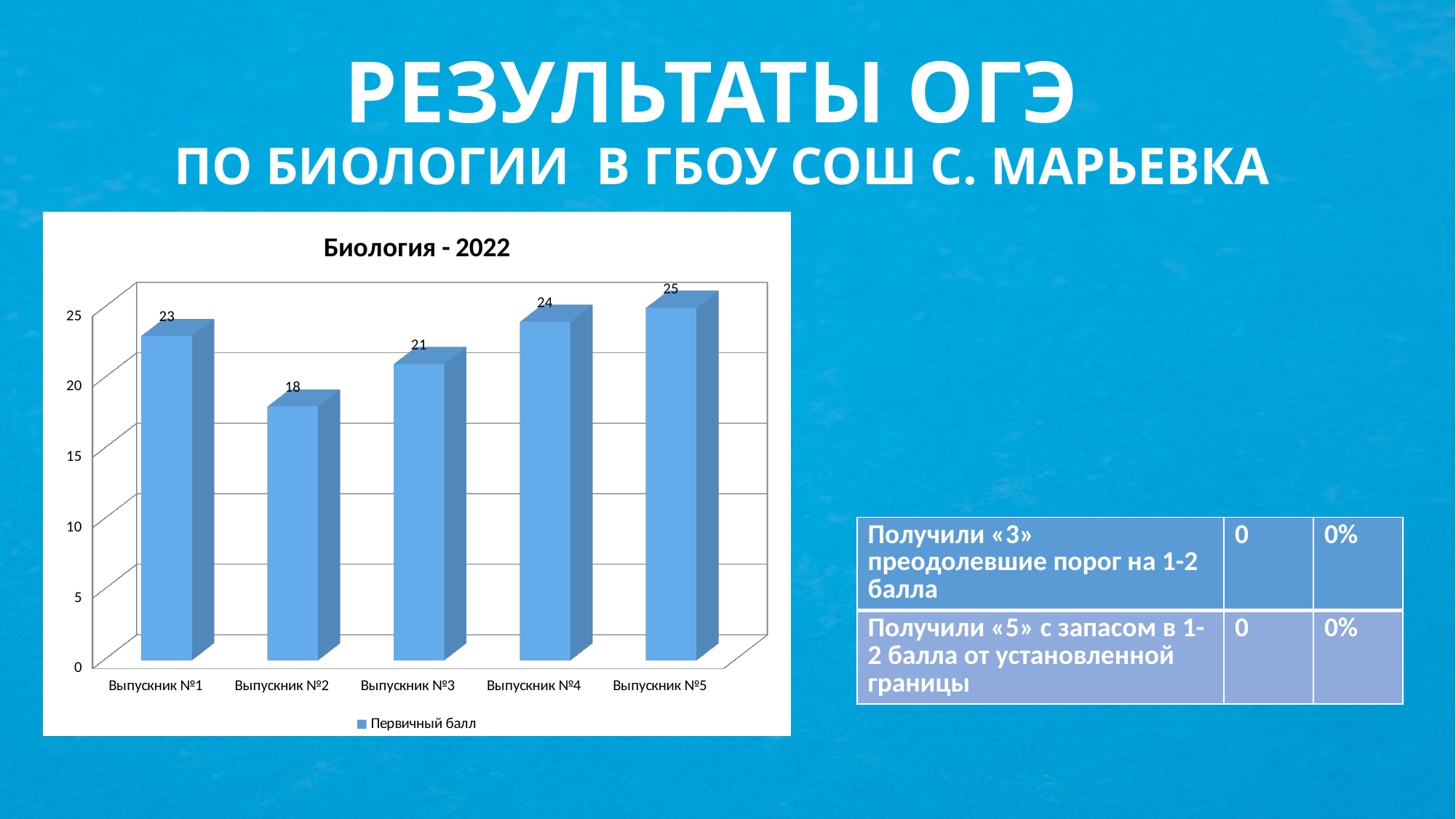
What is the value for Выпускник №2? 18 What is the value for Выпускник №1? 23 How many categories are shown on the x axis? 5 Which category has the highest value? Выпускник №5 What kind of chart is shown? bar chart Which is larger, the value for Выпускник №1 or Выпускник №4? Выпускник №4 Is the value for Выпускник №2 greater or less than 20? less What is the difference between the values for Выпускник №5 and Выпускник №2? 7 Which category has the lowest value? Выпускник №2 What is the title of the chart? Биология - 2022 What is the value for Выпускник №3? 21 What is the value for Выпускник №5? 25